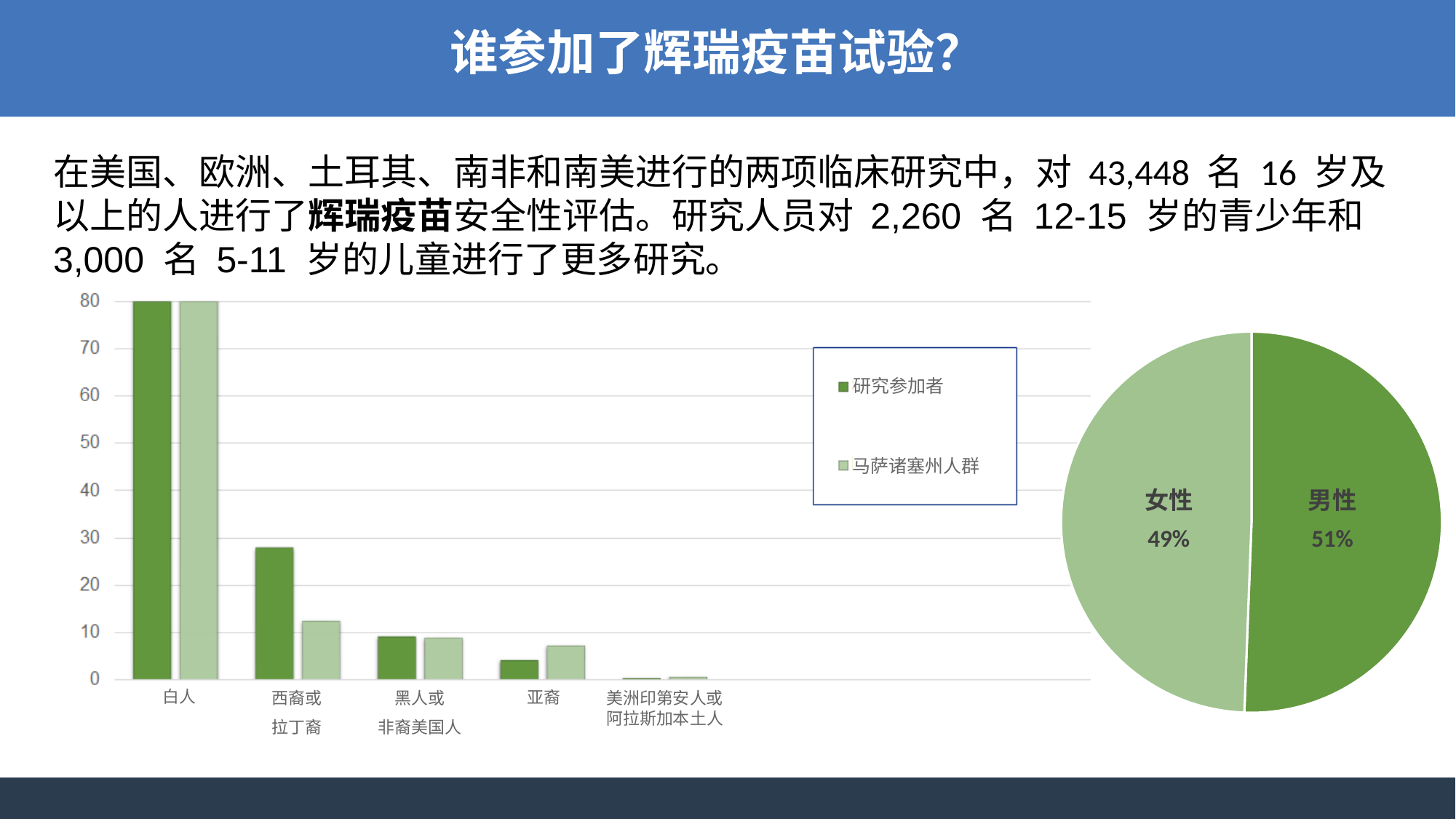
On the bar chart on the left, for 西裔或拉丁裔, which series has the larger value, 研究参加者 or 马萨诸塞州人群? 研究参加者 On the pie chart on the right, what is the difference between the 男性 and 女性 shares? 2% On the pie chart on the right, what share is labelled for 女性? 49% On the bar chart on the left, is the 研究参加者 value for 西裔或拉丁裔 greater or less than 20? greater On the bar chart on the left, is the 马萨诸塞州人群 value for 亚裔 greater or less than 10? less On the bar chart on the left, how many series does the legend list? 2 On the pie chart on the right, what share is labelled for 男性? 51% On the bar chart on the left, which category has the highest value for 研究参加者? 白人 On the bar chart on the left, how many categories are shown on the x axis? 5 On the pie chart on the right, how many slices are there? 2 On the pie chart on the right, which slice is larger, 女性 or 男性? 男性 What kind of chart is the chart on the left of the slide? bar chart